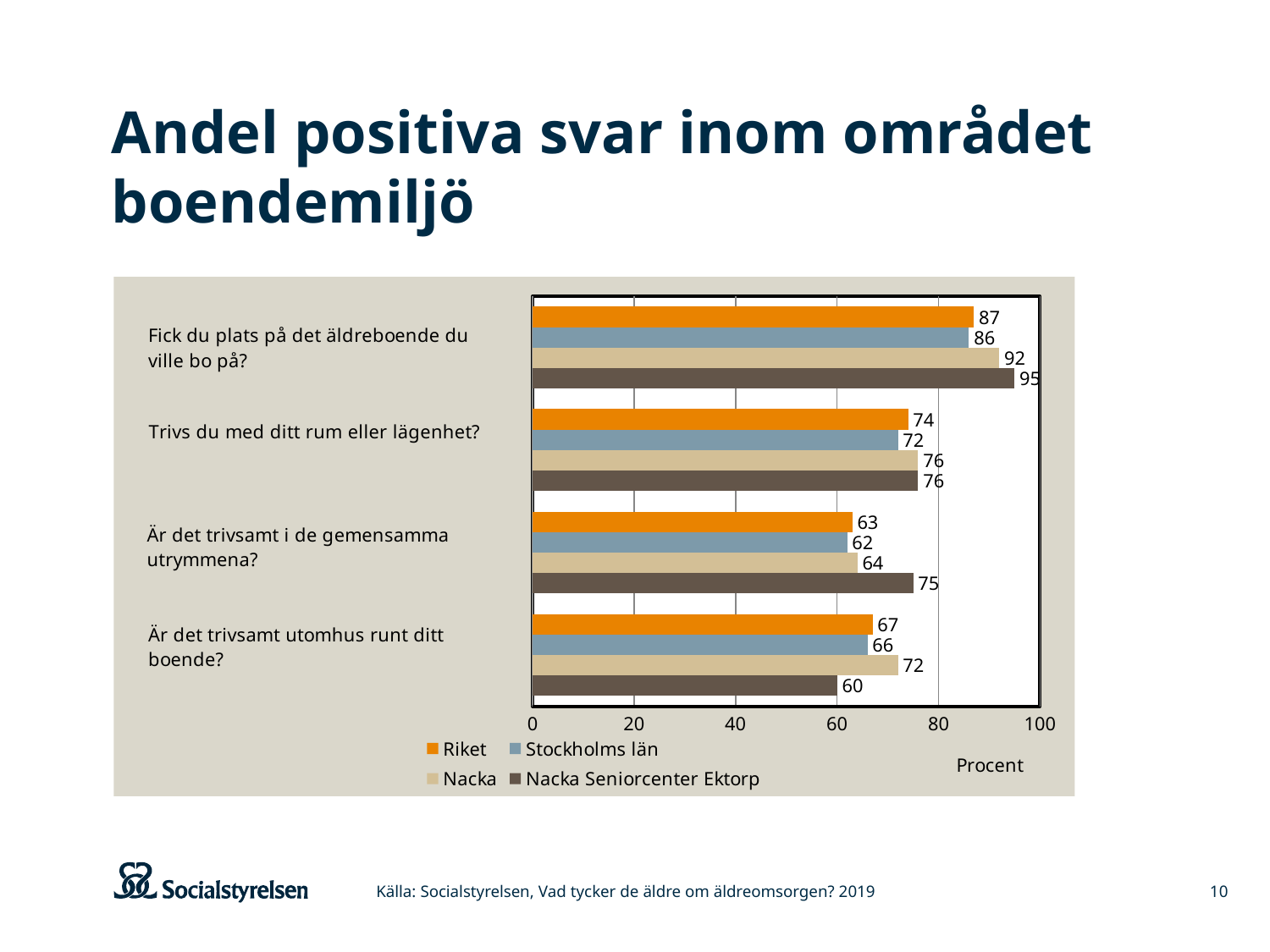
What kind of chart is shown on the slide? Bar chart What is the value for Stockholms län for "Är det trivsamt utomhus runt ditt boende?"? 66 How many questions (categories) are shown on the chart? 4 For which question does Nacka Seniorcenter Ektorp have its lowest value? Är det trivsamt utomhus runt ditt boende? What is the value for Nacka Seniorcenter Ektorp for "Fick du plats på det äldreboende du ville bo på?"? 95 What is the difference between Nacka Seniorcenter Ektorp and Nacka for "Är det trivsamt i de gemensamma utrymmena?"? 11 What is the value for Riket for "Trivs du med ditt rum eller lägenhet?"? 74 For which question does Riket have its highest value? Fick du plats på det äldreboende du ville bo på? What is the label on the horizontal axis of the chart? Procent What is the value for Nacka for "Är det trivsamt i de gemensamma utrymmena?"? 64 How many series does the legend list? 4 Which is larger for "Är det trivsamt utomhus runt ditt boende?": Nacka or Nacka Seniorcenter Ektorp? Nacka